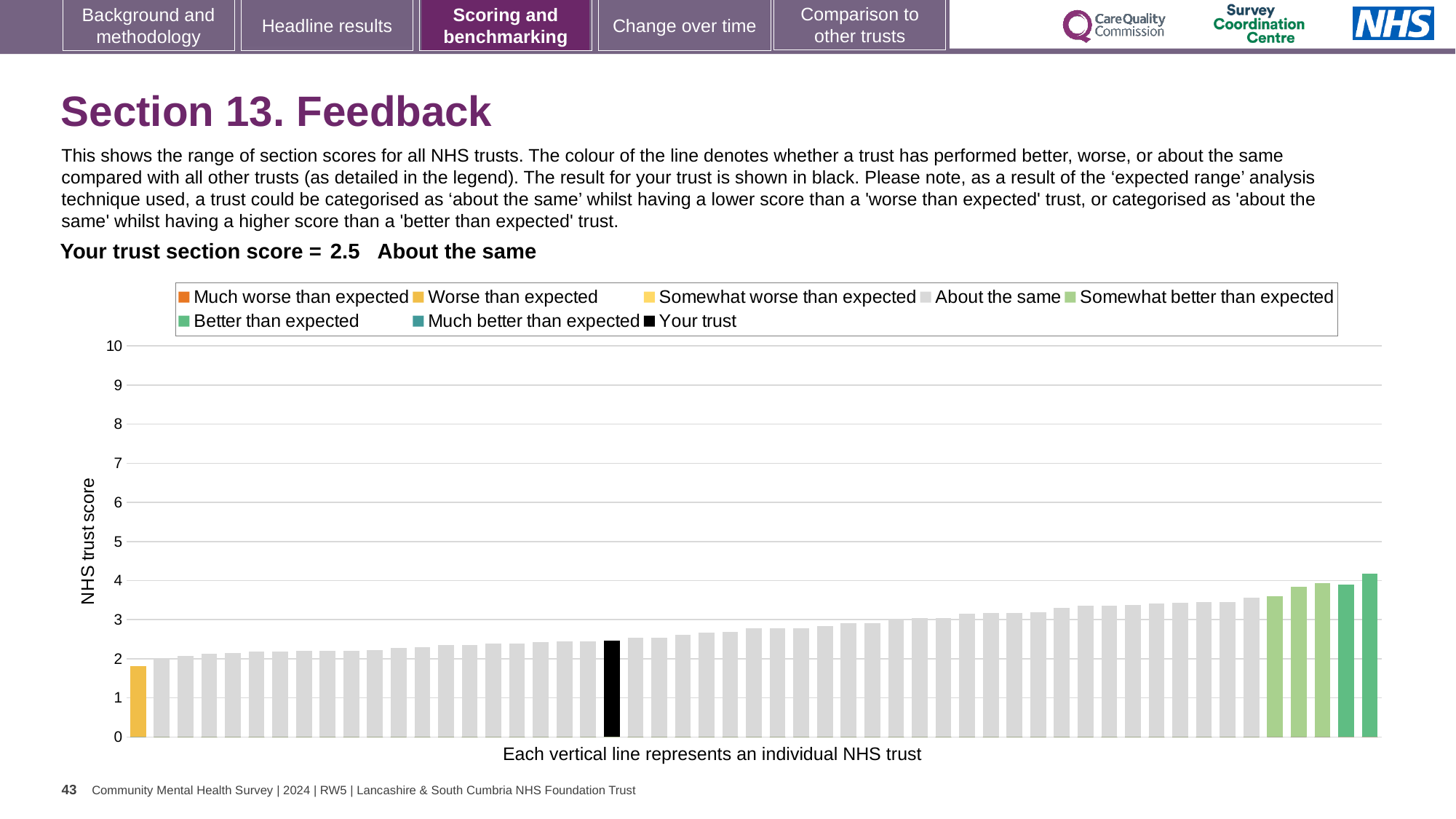
What is the label on the y axis of the chart? NHS trust score How many entries does the chart legend list? 8 What kind of chart is used to show the range of section scores? Bar chart What is the highest value shown on the y axis? 10 Which bar has the lowest score: the leftmost yellow bar or the black bar for your trust? The leftmost yellow bar Do the trust scores rise or fall from left to right along the x axis? Rise Which colour is used for the bar representing your trust? Black Is the value for the leftmost (yellow) bar greater or less than 2? less Is the value for the rightmost bar greater or less than 3? greater How is your trust categorised compared with other trusts in Section 13. Feedback? About the same Is the value for your trust (the black bar) greater or less than 3? less What is the section score for your trust shown on the slide? 2.5